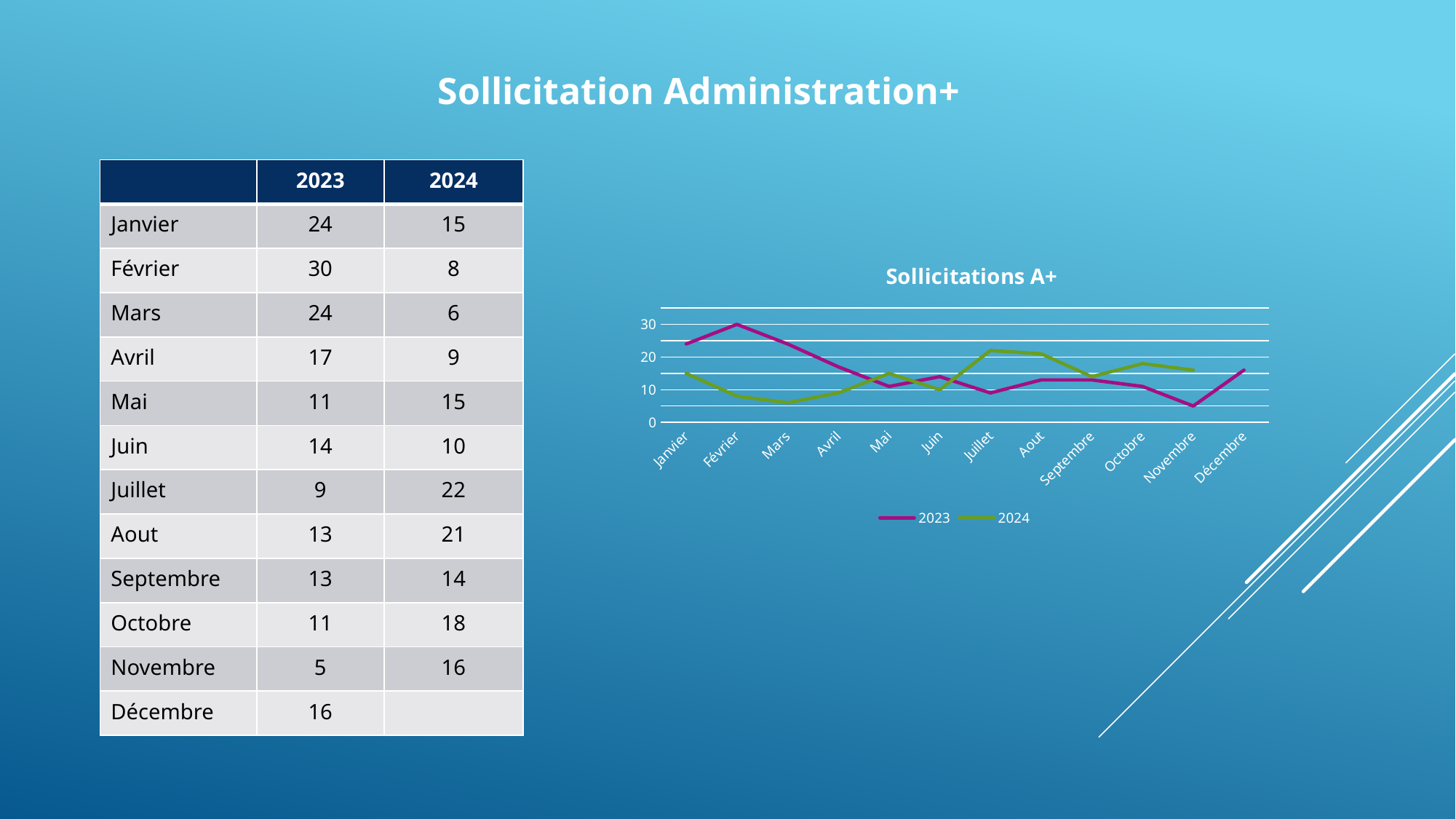
What is the difference between the 2023 and 2024 values in Février? 22 What is the value for 2024 in Juillet? 22 What is the value for 2023 in Février? 30 Which month has the lowest value for the 2024 series? Mars How many series does the chart legend list? 2 Which series has the larger value in Aout, 2023 or 2024? 2024 Is the value for 2024 in Mars greater or less than 10? less What is the title of the chart? Sollicitations A+ Which month has the lowest value for the 2023 series? Novembre How many months are shown on the x axis of the chart? 12 What kind of chart is shown on the slide? line chart Which month has the highest value for the 2023 series? Février